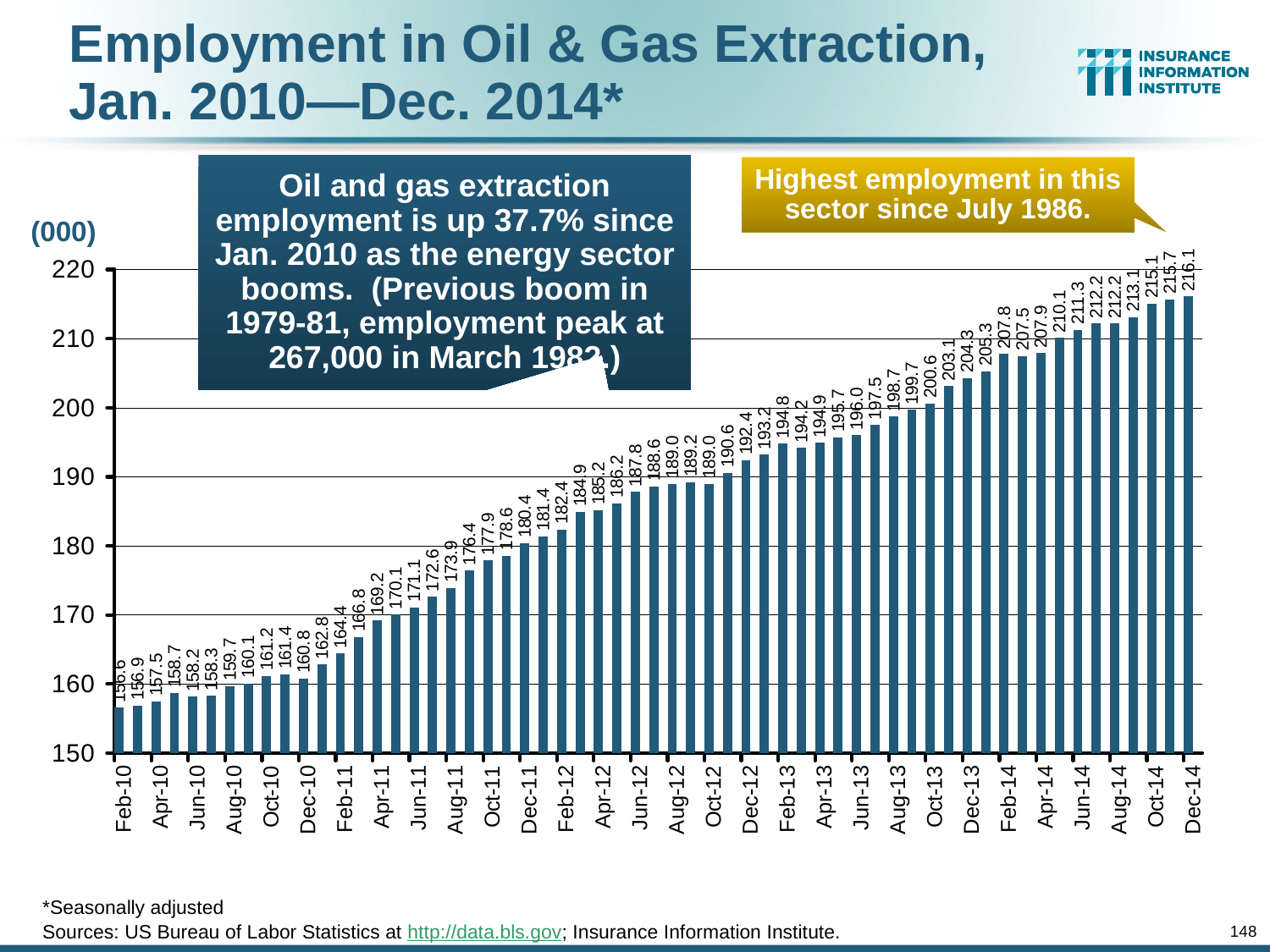
Is the value for Dec-12 greater or less than 190? greater What is the employment value for Dec-13? 204.3 Which month has the lowest employment value on the chart? Feb-10 Which month has the highest employment value on the chart? Dec-14 What is the employment value for Oct-14? 215.1 According to the yellow callout, since when is this the highest employment in the sector? July 1986 Do the employment values generally rise or fall from Feb-10 to Dec-14? rise What is the difference between the Dec-14 value and the Dec-13 value? 11.8 Which is larger, the value for Dec-14 or the value for Oct-14? Dec-14 What unit label is shown at the top of the y-axis? (000) What is the employment value for Dec-14? 216.1 What kind of chart is shown on the slide? bar chart